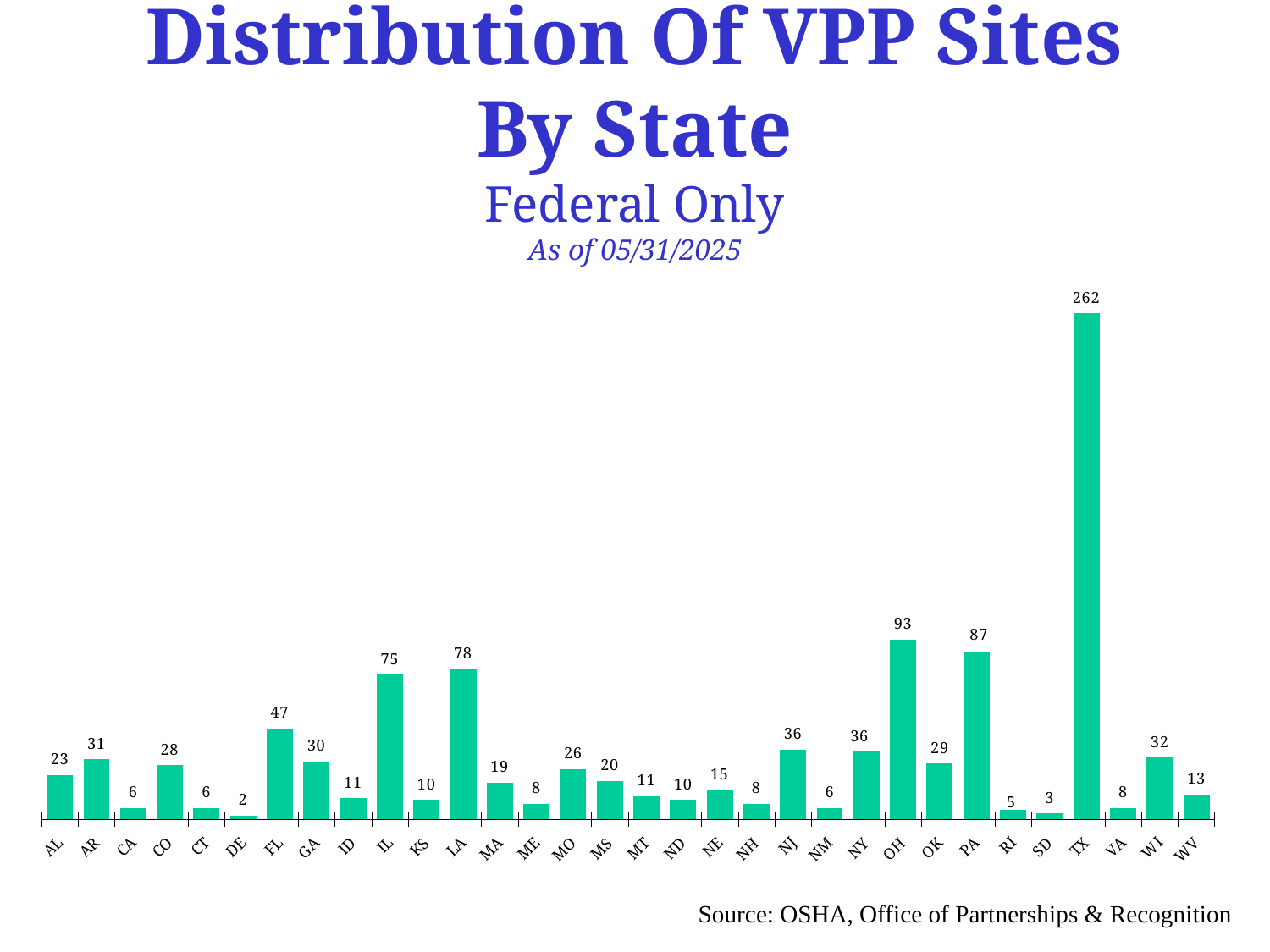
What is the value for LA? 78 Which state has the highest value? TX What kind of chart is shown on the slide? bar chart What is the value for TX? 262 Which is larger, the value for FL or the value for GA? FL What is the title of the chart? Distribution Of VPP Sites By State What is the difference between the values for TX and OH? 169 Which state has the lowest value? DE What is the value for MO? 26 How many states are shown on the x axis? 32 What is the difference between the values for OH and PA? 6 What is the value for OH? 93